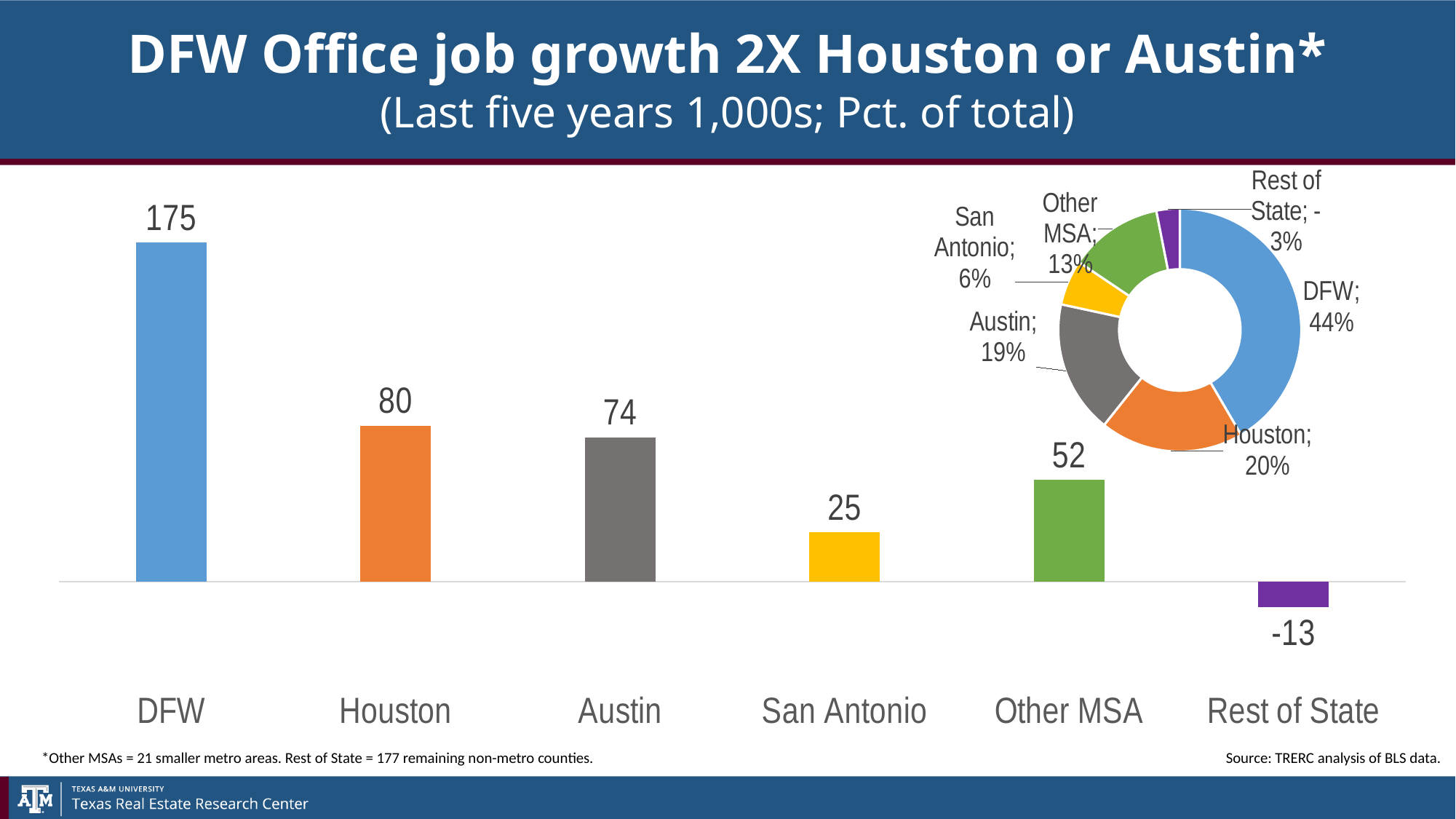
How many categories are shown in the bar chart on the left? 6 In the bar chart on the left, which category has the highest value? DFW In the bar chart on the left, what is the value for DFW? 175 In the donut chart on the right, which is larger, the share for Houston or the share for Austin? Houston What is the title of the slide? DFW Office job growth 2X Houston or Austin* In the bar chart on the left, which category has the lowest value? Rest of State In the bar chart on the left, what is the difference between the values for DFW and Houston? 95 In the bar chart on the left, what is the value for Rest of State? -13 In the donut chart on the right, what share does Other MSA have? 13% In the bar chart on the left, which is larger, the value for Other MSA or the value for San Antonio? Other MSA In the donut chart on the right, what share does DFW have? 44% What kind of chart is the chart on the left of the slide? Bar chart